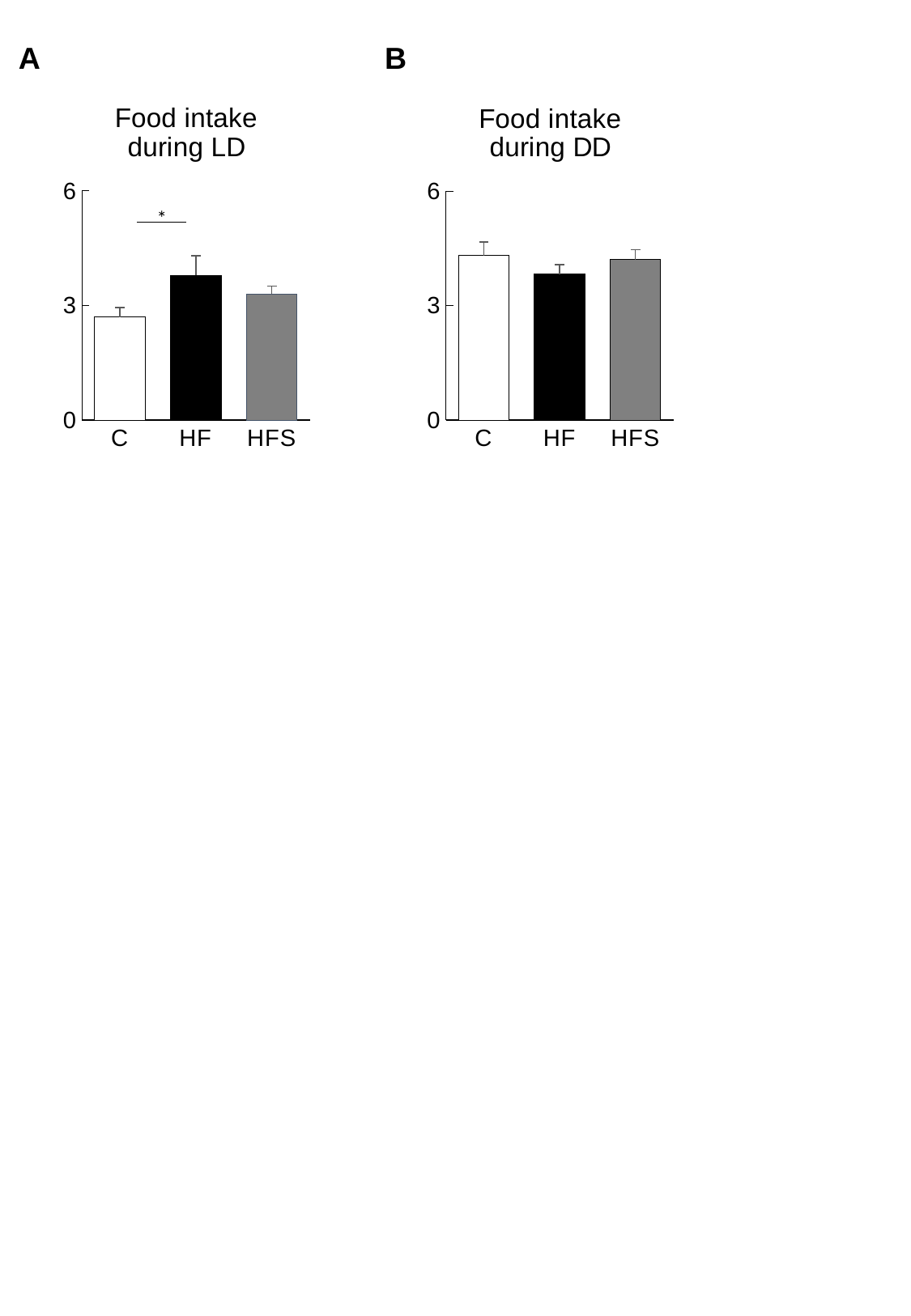
In the chart titled "Food intake during LD", which is larger, the value for C or the value for HF? HF In the chart titled "Food intake during DD", which category has the lowest value? HF In the chart titled "Food intake during LD", is the value for HF greater or less than 3? greater In the chart titled "Food intake during LD", is the value for C greater or less than 3? less In the chart titled "Food intake during LD", what colour is the HF bar? black In the chart titled "Food intake during LD", which category has the highest value? HF What kind of chart is the chart titled "Food intake during DD"? bar chart In the chart titled "Food intake during LD", which category has the lowest value? C In the chart titled "Food intake during DD", which is larger, the value for C or the value for HF? C In the chart titled "Food intake during DD", is the value for HF greater or less than 6? less How many categories are shown in the chart titled "Food intake during LD"? 3